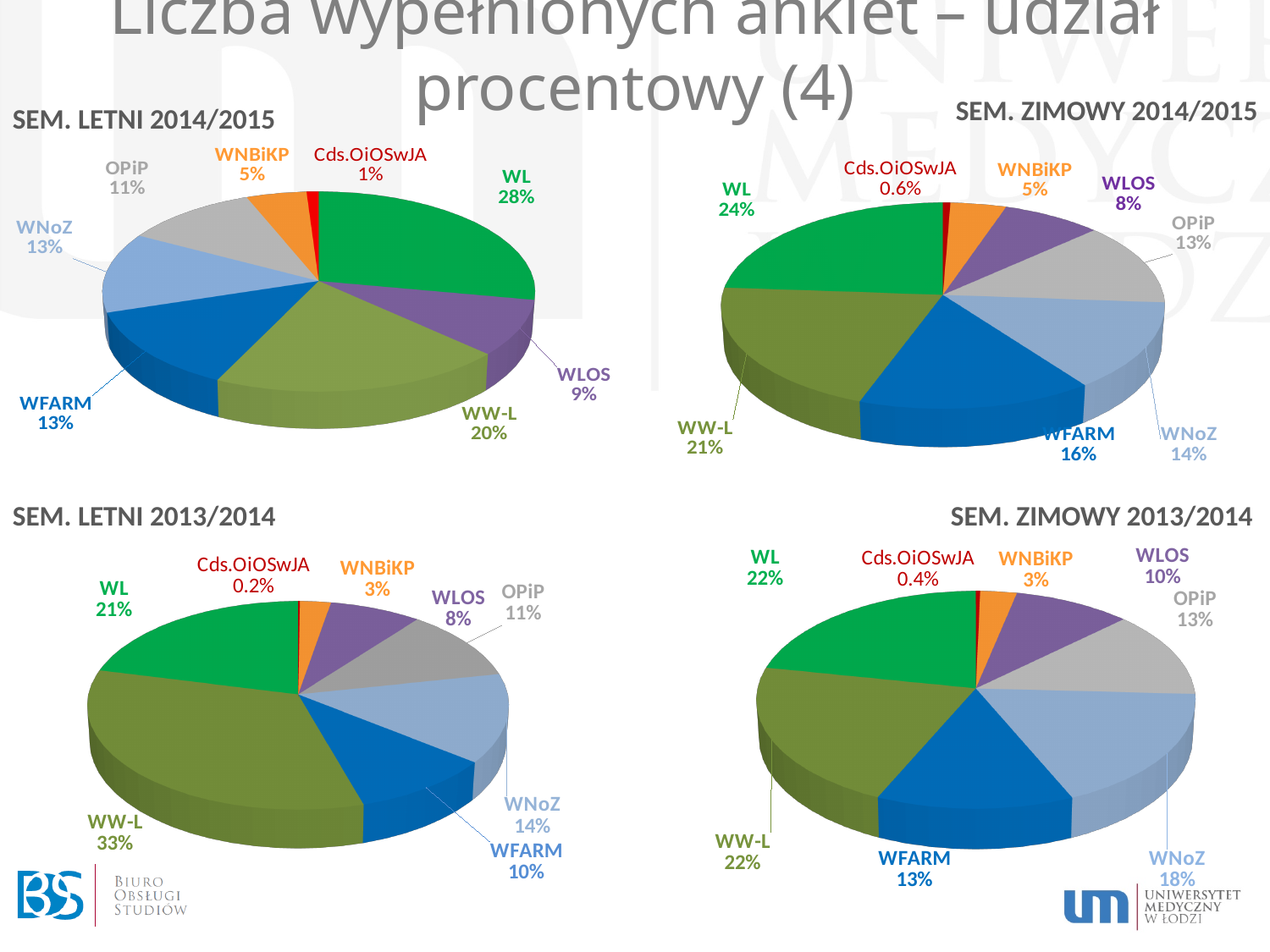
In the SEM. ZIMOWY 2014/2015 chart, what share does WFARM have? 16% In the SEM. ZIMOWY 2013/2014 chart, which is larger, the share of WNoZ or the share of WFARM? WNoZ In the SEM. ZIMOWY 2014/2015 chart, what is the difference between the shares of WL and WW-L? 3% In the SEM. ZIMOWY 2013/2014 chart, what share does WNoZ have? 18% In the SEM. LETNI 2013/2014 chart, what share does WW-L have? 33% What type of chart is used for SEM. ZIMOWY 2014/2015? Pie chart In the SEM. ZIMOWY 2014/2015 chart, which category has the smallest share? Cds.OiOSwJA In the SEM. LETNI 2014/2015 chart, what share does WL have? 28% In the SEM. LETNI 2013/2014 chart, what is the difference between the shares of WW-L and WL? 12% In the SEM. LETNI 2014/2015 chart, which category has the largest share? WL How many pie charts are shown on the slide? 4 How many slices does the SEM. LETNI 2014/2015 pie chart have? 8